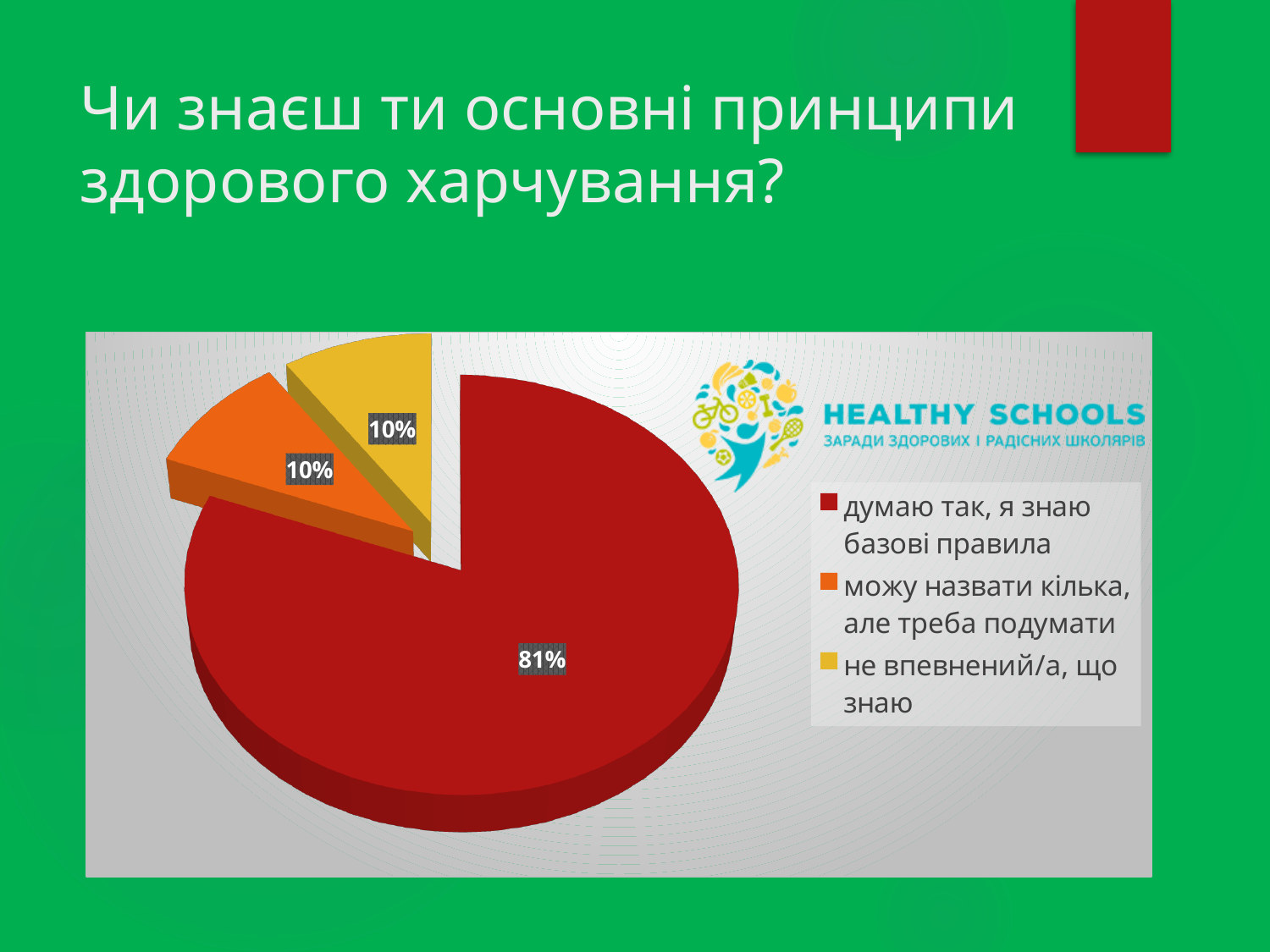
What is the value shown for "можу назвати кілька, але треба подумати"? 10% What is the difference in percentage points between the "думаю так, я знаю базові правила" slice and the "можу назвати кілька, але треба подумати" slice? 71 percentage points What kind of chart is shown on the slide? Pie chart How many slices does the pie chart have? 3 What is the value shown for "не впевнений/а, що знаю"? 10% What colour is the slice for "не впевнений/а, що знаю"? Yellow Which category has the largest slice of the pie? думаю так, я знаю базові правила Which is larger: the slice for "думаю так, я знаю базові правила" or the slice for "не впевнений/а, що знаю"? думаю так, я знаю базові правила What share of the pie does the slice "думаю так, я знаю базові правила" represent? 81% How many entries does the legend list? 3 What question is the chart on the slide answering, according to the slide title? Чи знаєш ти основні принципи здорового харчування?